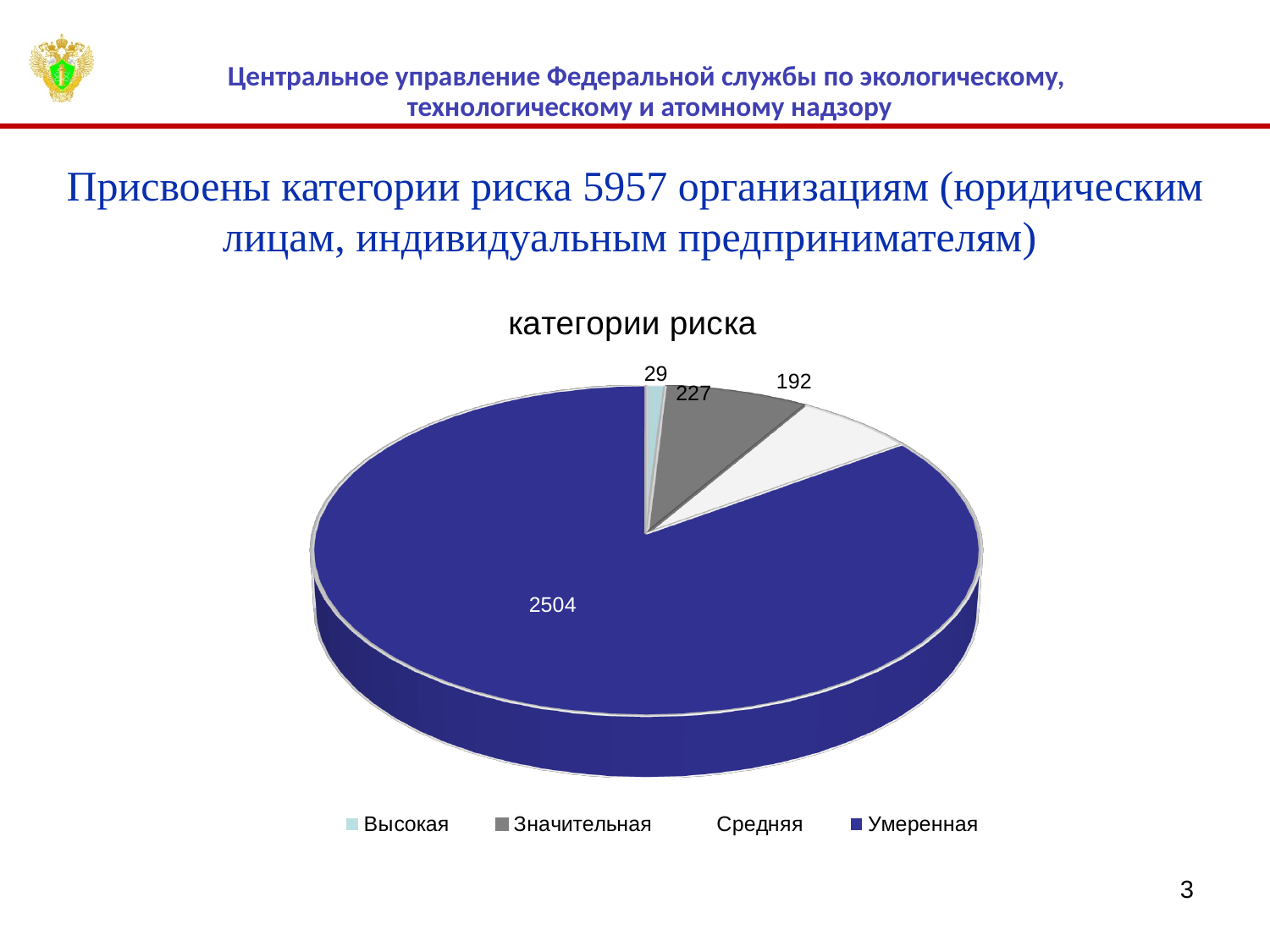
How many categories does the pie chart show? 4 Which category is shown in dark blue in the legend? Умеренная What type of chart is shown on the slide? pie chart What is the value for the Умеренная category? 2504 What is the difference between the Значительная and Средняя values? 35 What is the title of the chart? категории риска What is the value for the Значительная category? 227 Which category has the largest slice? Умеренная What is the value for the Высокая category? 29 Which category has the smallest slice? Высокая Which is larger, the value for Значительная or the value for Средняя? Значительная What is the value for the Средняя category? 192